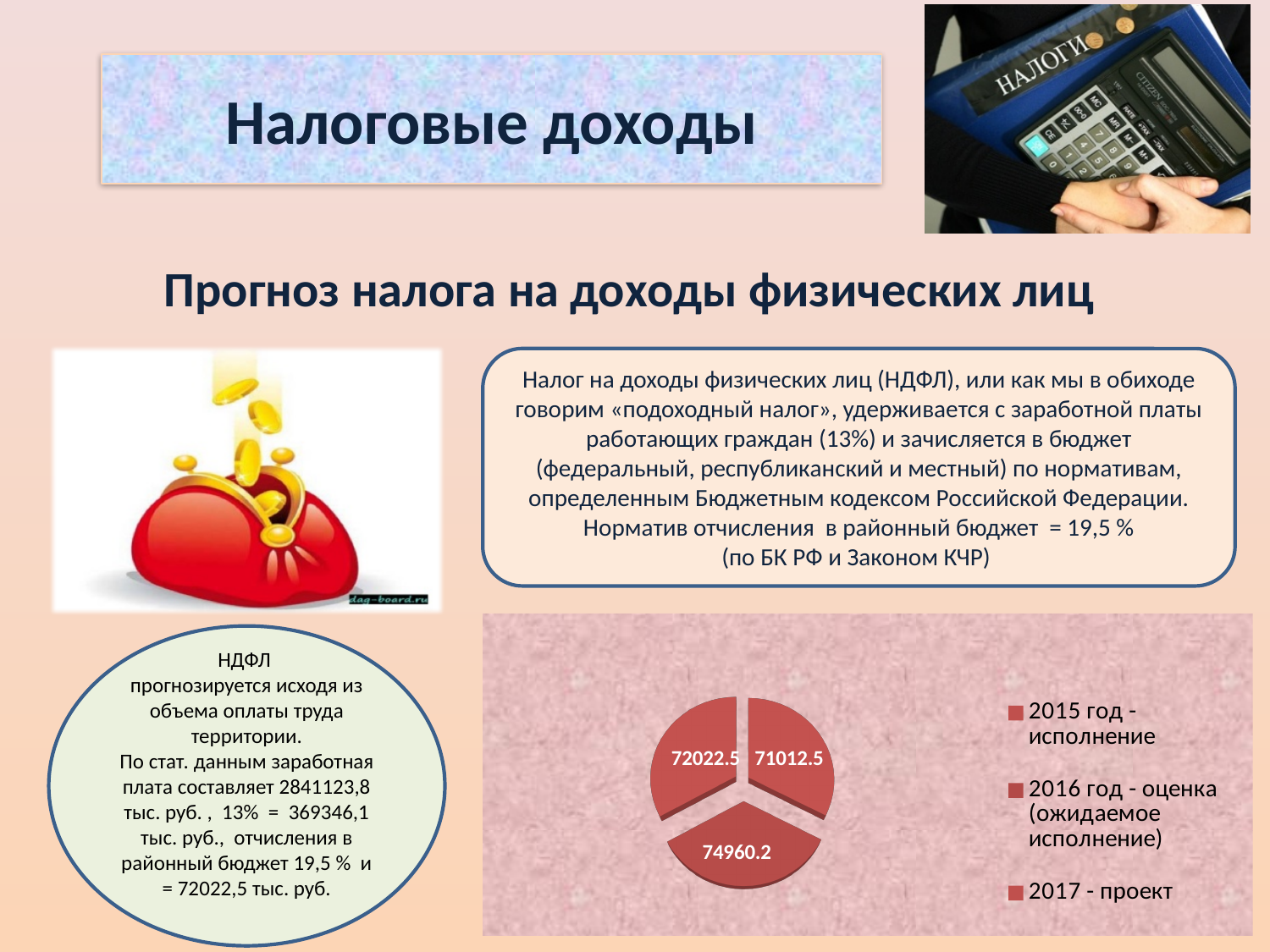
What is the total of all three slices on the pie chart? 217995.2 How many entries does the pie chart's legend list? 3 What is the last legend entry of the pie chart? 2017 - проект Which is larger on the pie chart: the slice labelled 72022.5 or the slice labelled 71012.5? 72022.5 What is the difference between the slices labelled 74960.2 and 72022.5 on the pie chart? 2937.7 What kind of chart is shown on the slide? pie chart What is the difference between the slices labelled 72022.5 and 71012.5 on the pie chart? 1010 What is the difference between the largest slice (74960.2) and the smallest slice (71012.5) on the pie chart? 3947.7 What is the largest value shown on the pie chart? 74960.2 What is the first legend entry of the pie chart? 2015 год - исполнение How many slices does the pie chart have? 3 What is the smallest value shown on the pie chart? 71012.5